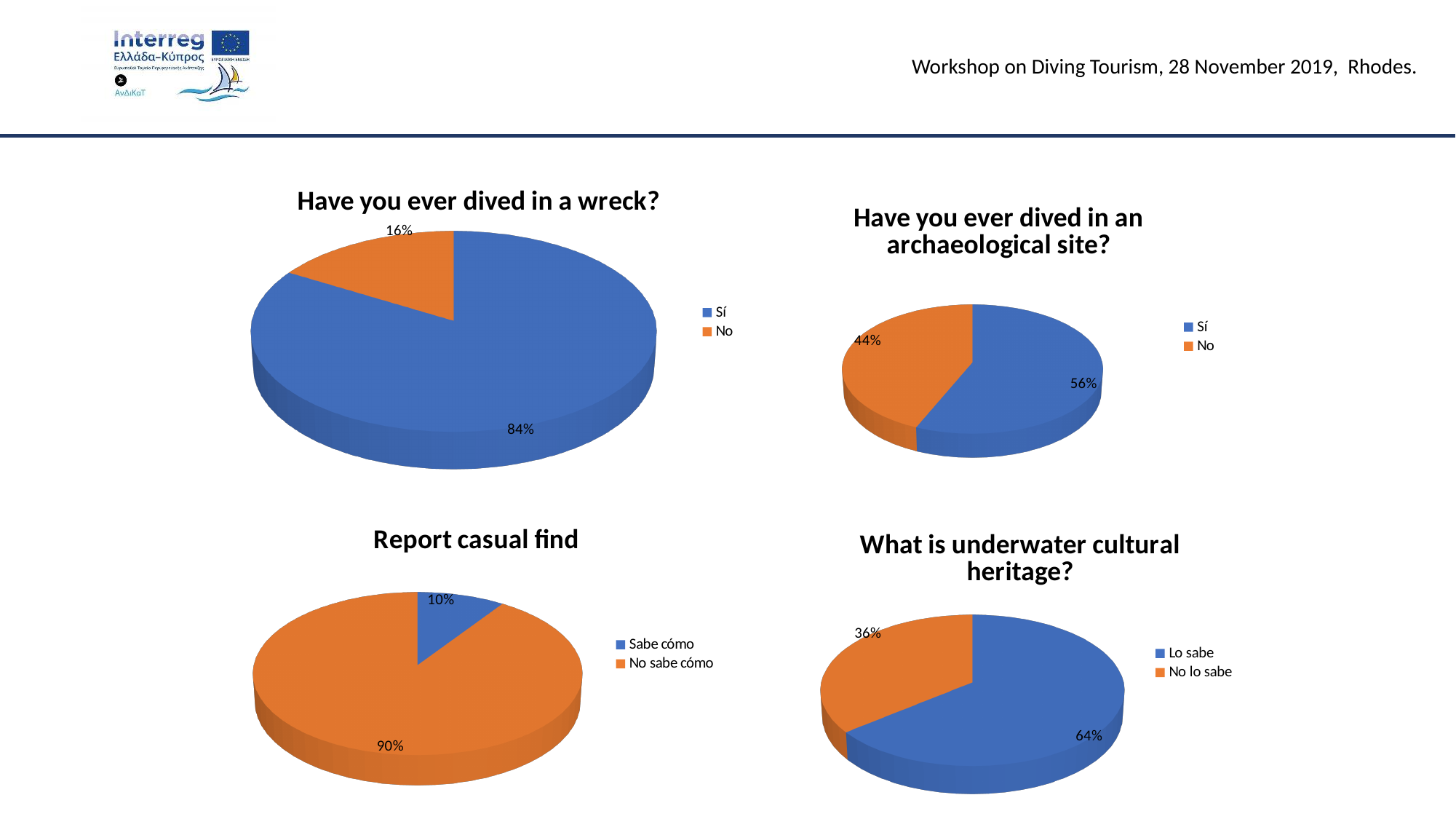
In the 'Have you ever dived in a wreck?' chart, what colour is the Sí slice? Blue In the 'Report casual find' chart, which slice is the smallest? Sabe cómo How many slices does the 'Report casual find' chart have? 2 In the 'What is underwater cultural heritage?' chart, what percentage is 'Lo sabe'? 64% How many entries does the legend of the 'What is underwater cultural heritage?' chart list? 2 In the 'Have you ever dived in a wreck?' chart, what percentage answered Sí? 84% In the 'Have you ever dived in an archaeological site?' chart, what is the difference between the Sí and No shares? 12% What kind of chart is 'Have you ever dived in a wreck?' Pie chart In the 'Have you ever dived in an archaeological site?' chart, what percentage answered Sí? 56% In the 'Have you ever dived in a wreck?' chart, what percentage answered No? 16% In the 'Report casual find' chart, what percentage is 'No sabe cómo'? 90% In the 'What is underwater cultural heritage?' chart, which is larger, 'Lo sabe' or 'No lo sabe'? Lo sabe